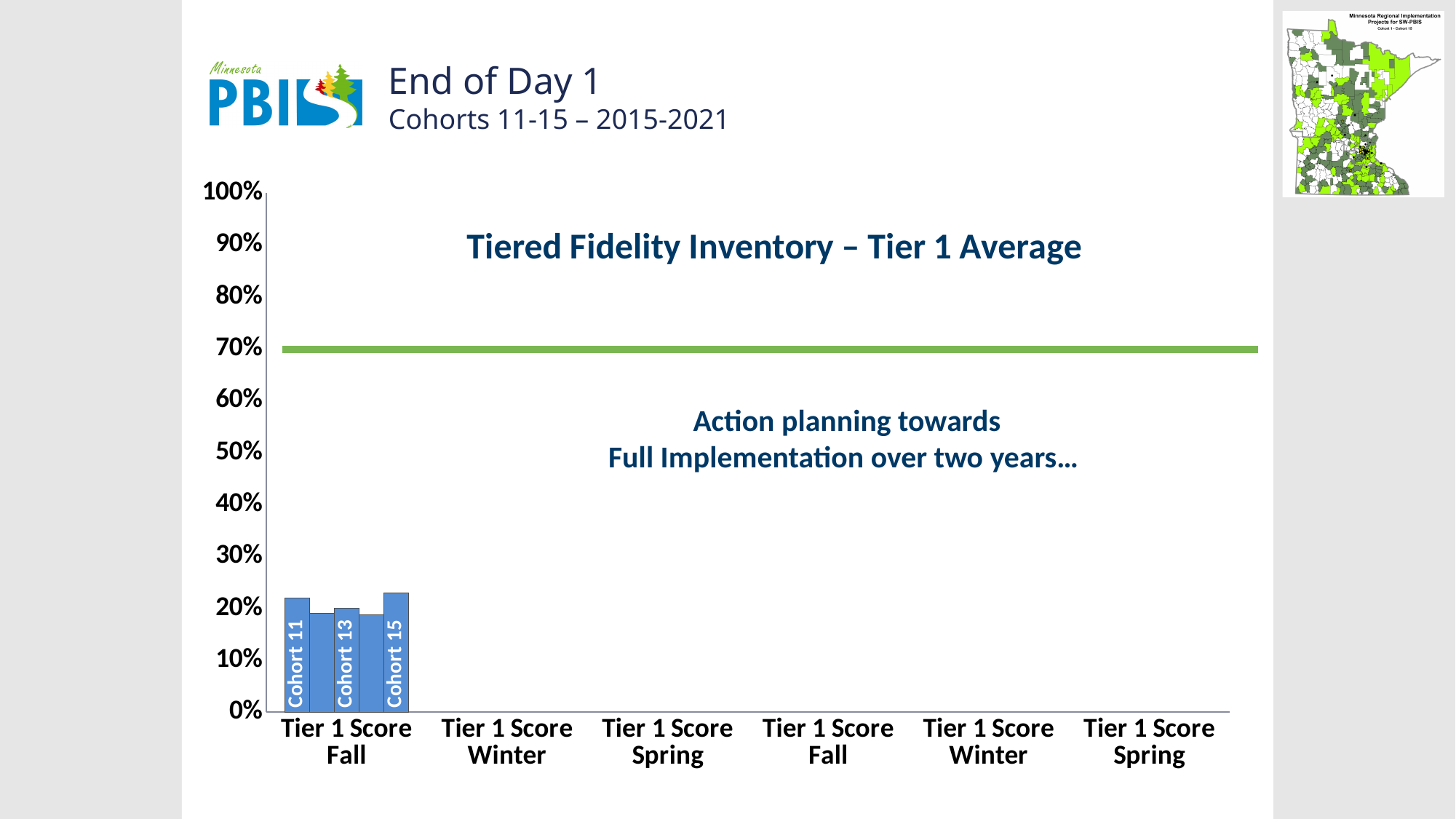
Which x-axis category is the only one with bars plotted? Tier 1 Score Fall What is the highest value shown on the y axis of the chart? 100% Is the value for Cohort 11 in the Tier 1 Score Fall category greater or less than 30%? less What is the title of the chart? Tiered Fidelity Inventory – Tier 1 Average Is the value for Cohort 15 in the Tier 1 Score Fall category greater or less than 10%? greater Is the value for Cohort 13 in the Tier 1 Score Fall category greater or less than 30%? less How many categories are labelled along the x axis of the chart? 6 What kind of chart is shown on the slide? bar chart